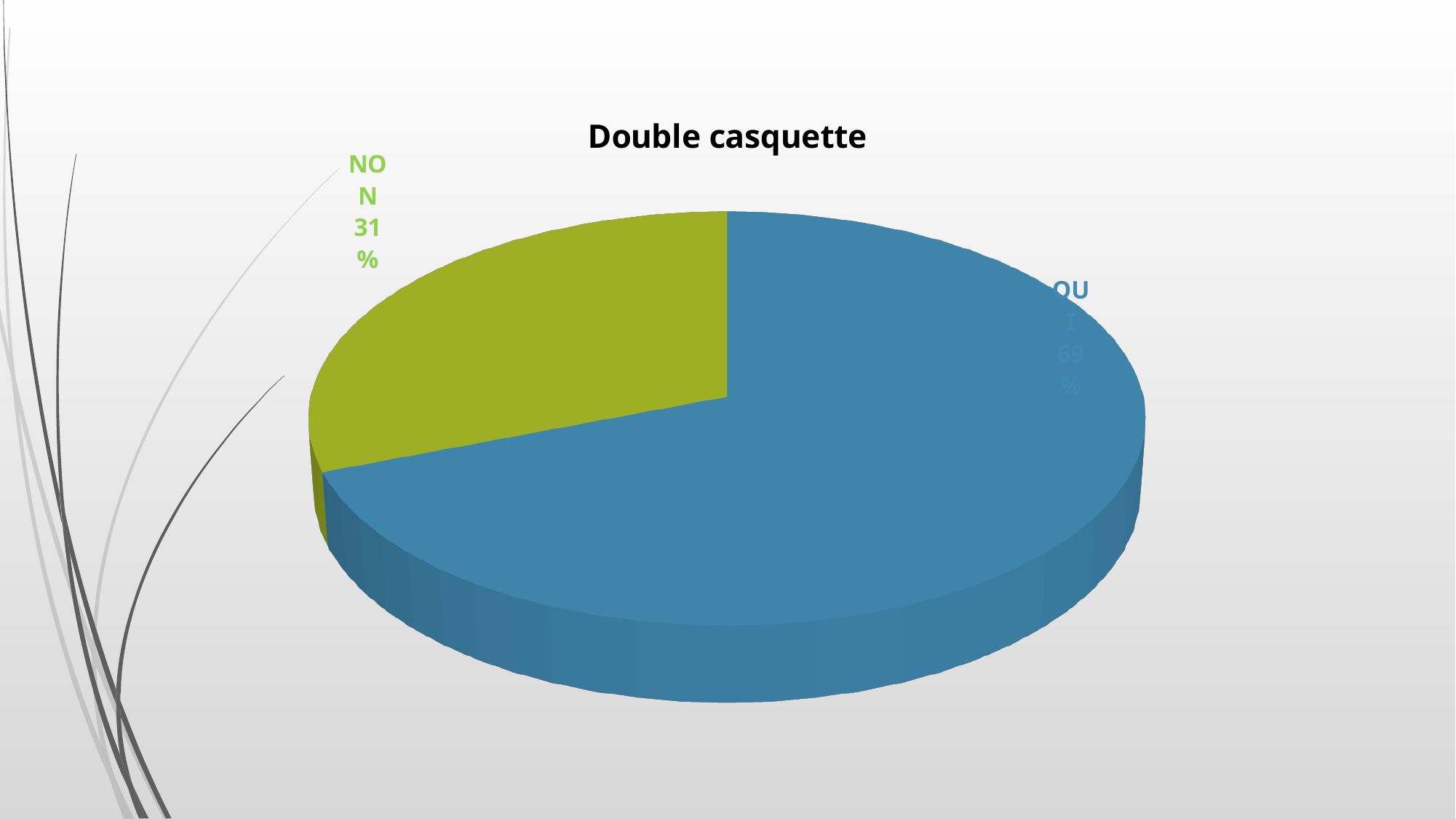
How many slices does the pie chart have? 2 Which slice is the smallest in the pie chart? NON What colour is the NON slice? green What is the difference in percentage points between the OUI and NON slices? 38 What share of the pie does the NON slice represent? 31% Is the share for NON greater or less than 50%? less What is the title of the chart? Double casquette What kind of chart is shown on the slide? pie chart Which slice is the largest in the pie chart? OUI Which is larger, the OUI slice or the NON slice? OUI What share of the pie does the OUI slice represent? 69%